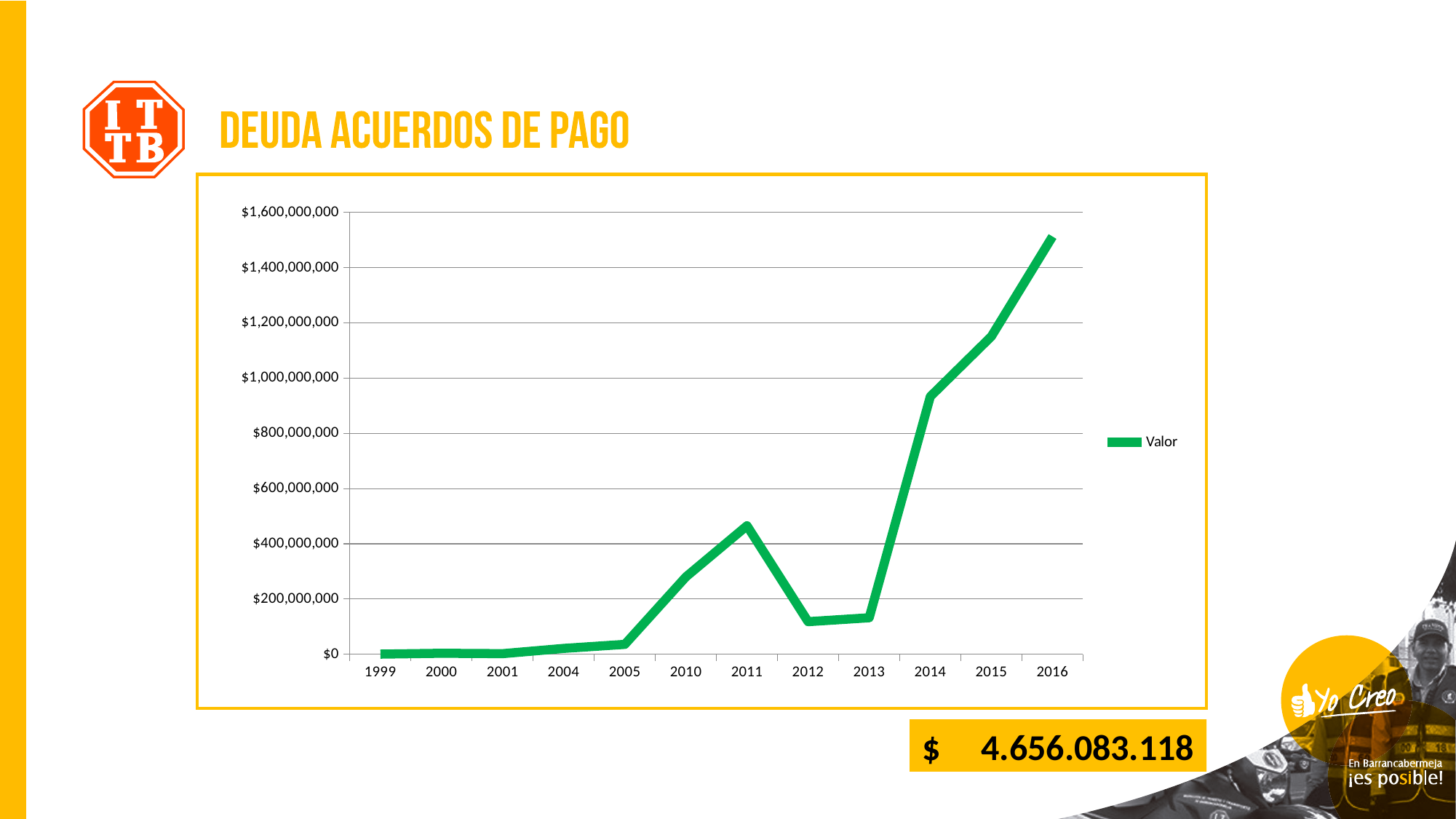
Is the value for 2014 greater or less than $800,000,000? greater Is the value for 2016 greater or less than $1,400,000,000? greater How many series does the chart's legend list? 1 Is the value for 2011 greater or less than $400,000,000? greater Which year has the highest value in the chart? 2016 How many years are plotted along the x axis of the chart? 12 Overall, do the values rise or fall from 1999 to 2016? rise What is the name of the series shown in the chart's legend? Valor Which year has the larger value, 2011 or 2012? 2011 What kind of chart is shown on the slide? line chart